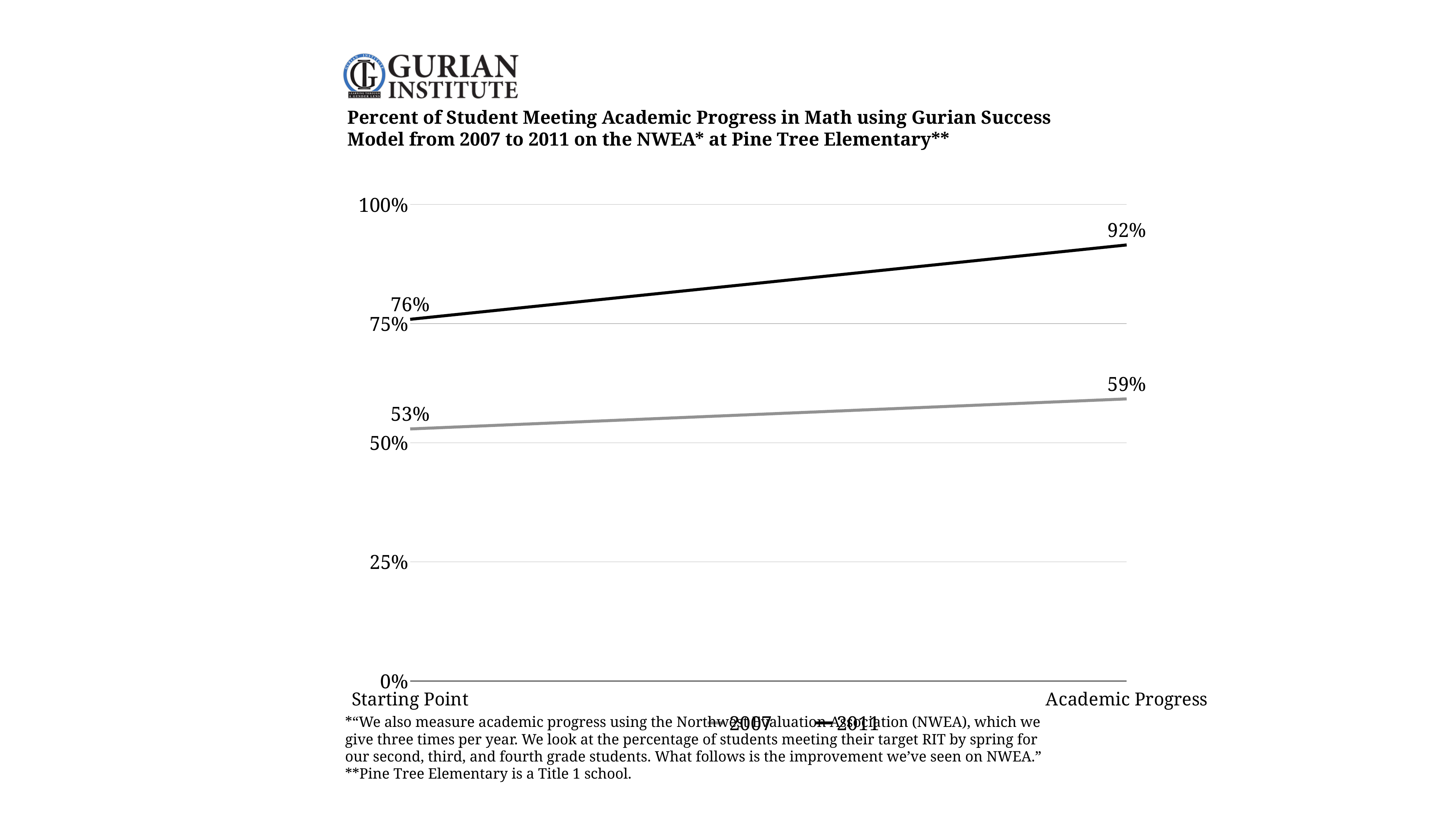
How many series does the legend list? 2 At Academic Progress, which line has the larger value, the black line or the gray line? The black line What is the value of the black line at Academic Progress? 92% What is the value of the black line at Starting Point? 76% What kind of chart is shown on the slide? Line chart By how many percentage points does the gray line rise from Starting Point to Academic Progress? 6 percentage points By how many percentage points does the black line rise from Starting Point to Academic Progress? 16 percentage points What is the highest value plotted on the chart? 92% What is the value of the gray line at Academic Progress? 59% How many categories are shown on the x axis? 2 What is the value of the gray line at Starting Point? 53% Does the black line rise or fall from Starting Point to Academic Progress? Rise